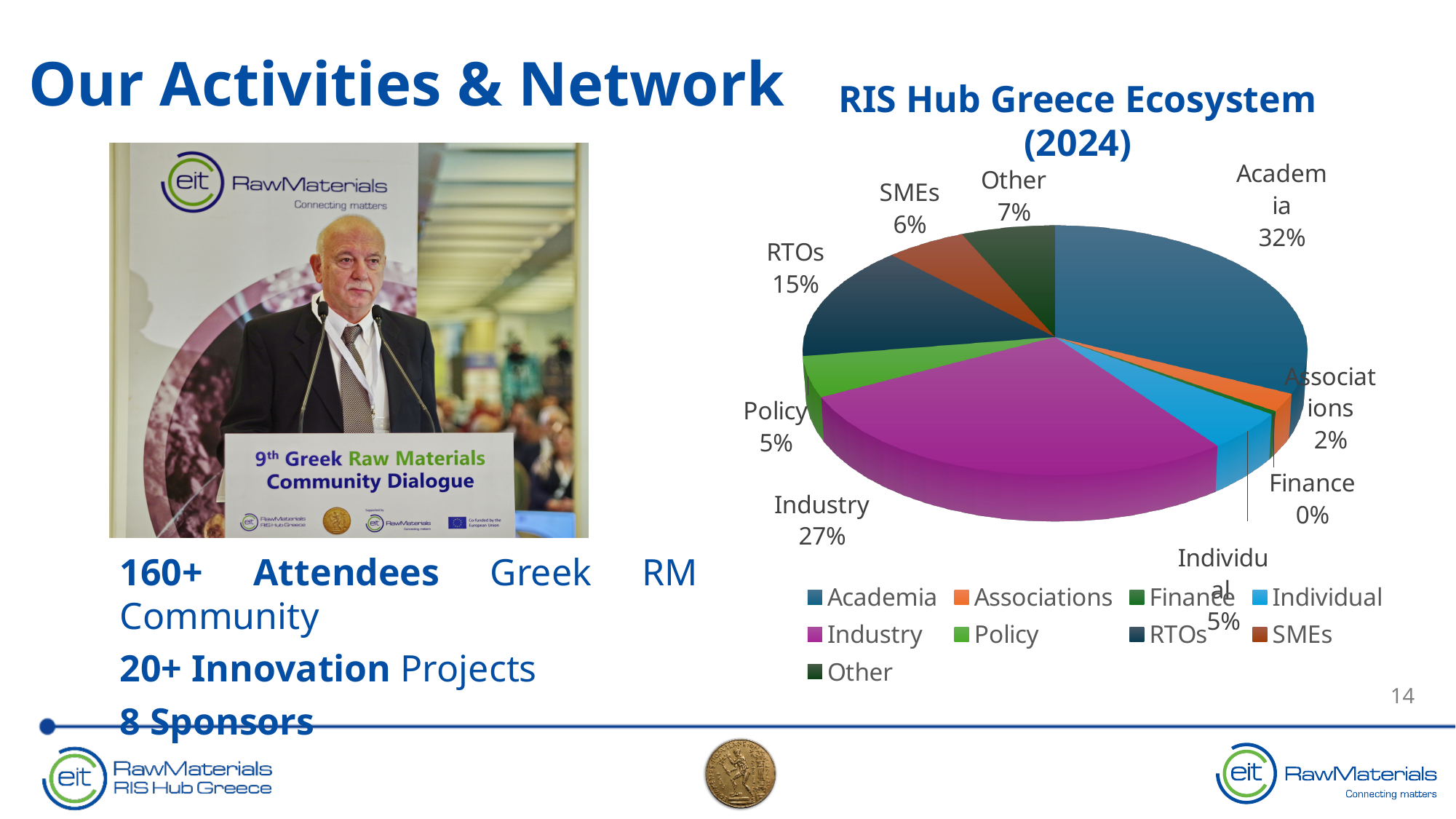
What percentage is shown for SMEs? 6% What is the title of the chart? RIS Hub Greece Ecosystem (2024) What is the combined share of Policy and Individual? 10% What percentage is shown for RTOs? 15% What percentage is shown for Industry? 27% What share of the pie does Academia hold? 32% Which is larger, the share for RTOs or the share for Other? RTOs What type of chart is shown on the slide? pie chart How many categories does the legend list? 9 What is the difference in percentage points between Academia and Industry? 5 Which category has the largest share of the pie? Academia Which category has the smallest share of the pie? Finance